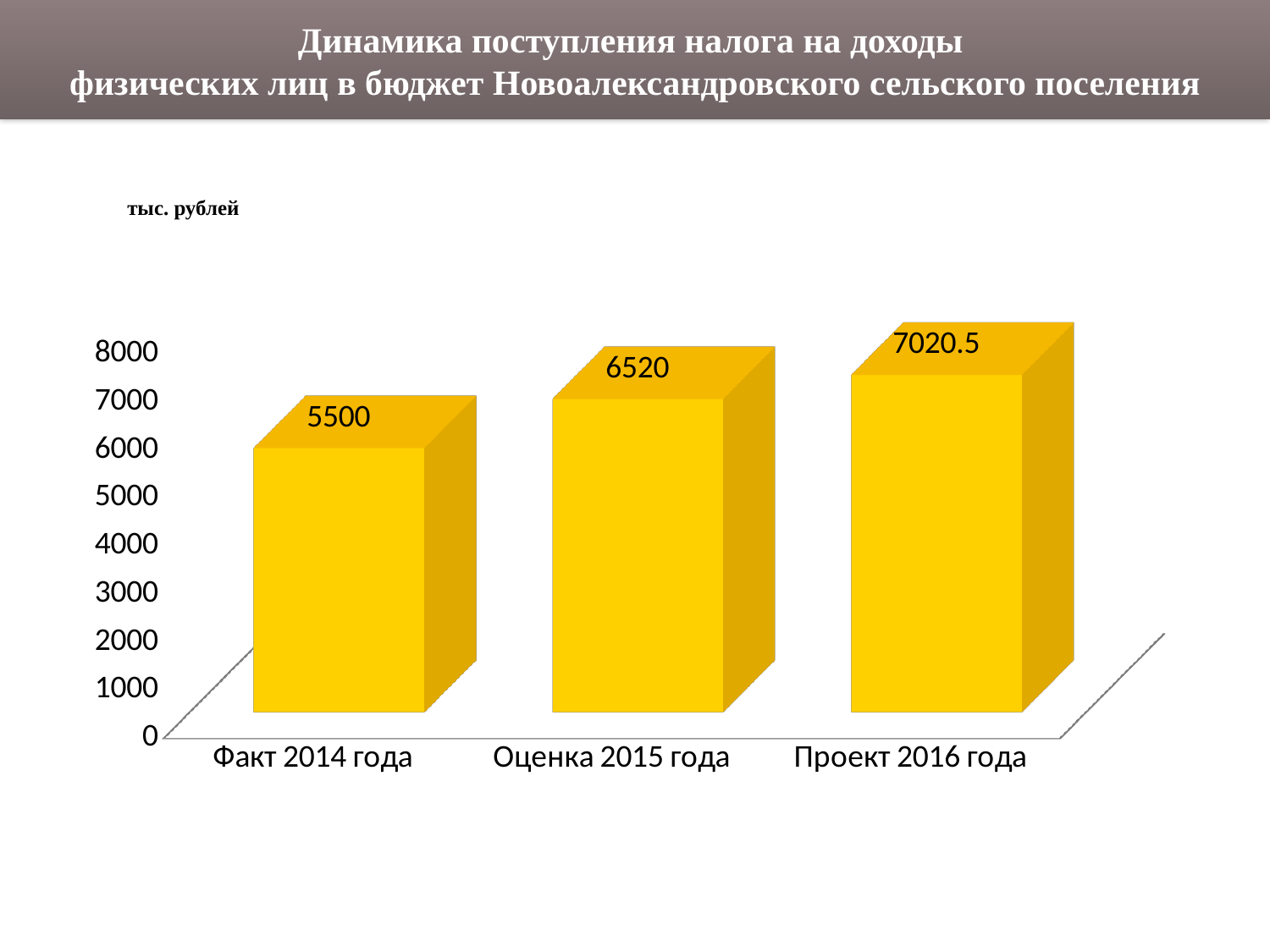
What is the difference between the values for Проект 2016 года and Оценка 2015 года? 500.5 What is the difference between the values for Оценка 2015 года and Факт 2014 года? 1020 What is the value for Оценка 2015 года? 6520 What kind of chart is shown on the slide? bar chart What is the value for Проект 2016 года? 7020.5 Which category has the lowest value? Факт 2014 года How many categories are shown on the x axis? 3 What unit is indicated above the chart? тыс. рублей Do the values rise or fall from Факт 2014 года to Проект 2016 года? rise Which is larger, the value for Факт 2014 года or the value for Проект 2016 года? Проект 2016 года What is the value for Факт 2014 года? 5500 Which category has the highest value? Проект 2016 года